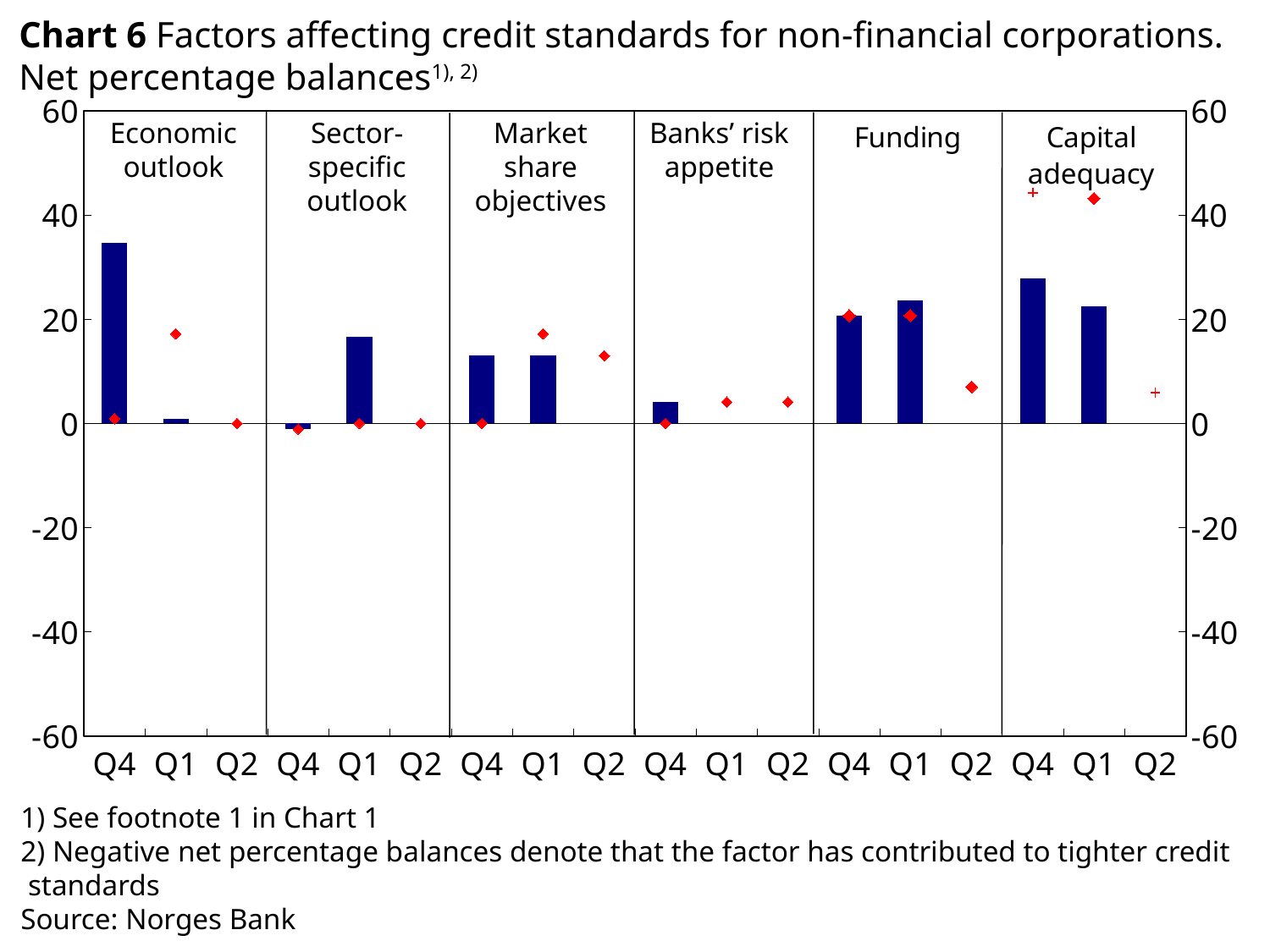
What kind of chart is Chart 6? Combination bar and marker (line) chart Is the Q4 bar for Economic outlook greater or less than 20? greater How many quarters are shown within each panel of Chart 6? 3 Is the Q4 bar for Sector-specific outlook greater or less than 0? less For Capital adequacy, which bar is larger, Q4 or Q1? Q4 Which factor has the highest Q4 bar? Economic outlook What is the source given for Chart 6? Norges Bank Is the Q1 bar for Funding greater or less than 20? greater How many factors (panels) are shown in Chart 6? 6 Do the bars for Economic outlook rise or fall from Q4 to Q2? fall